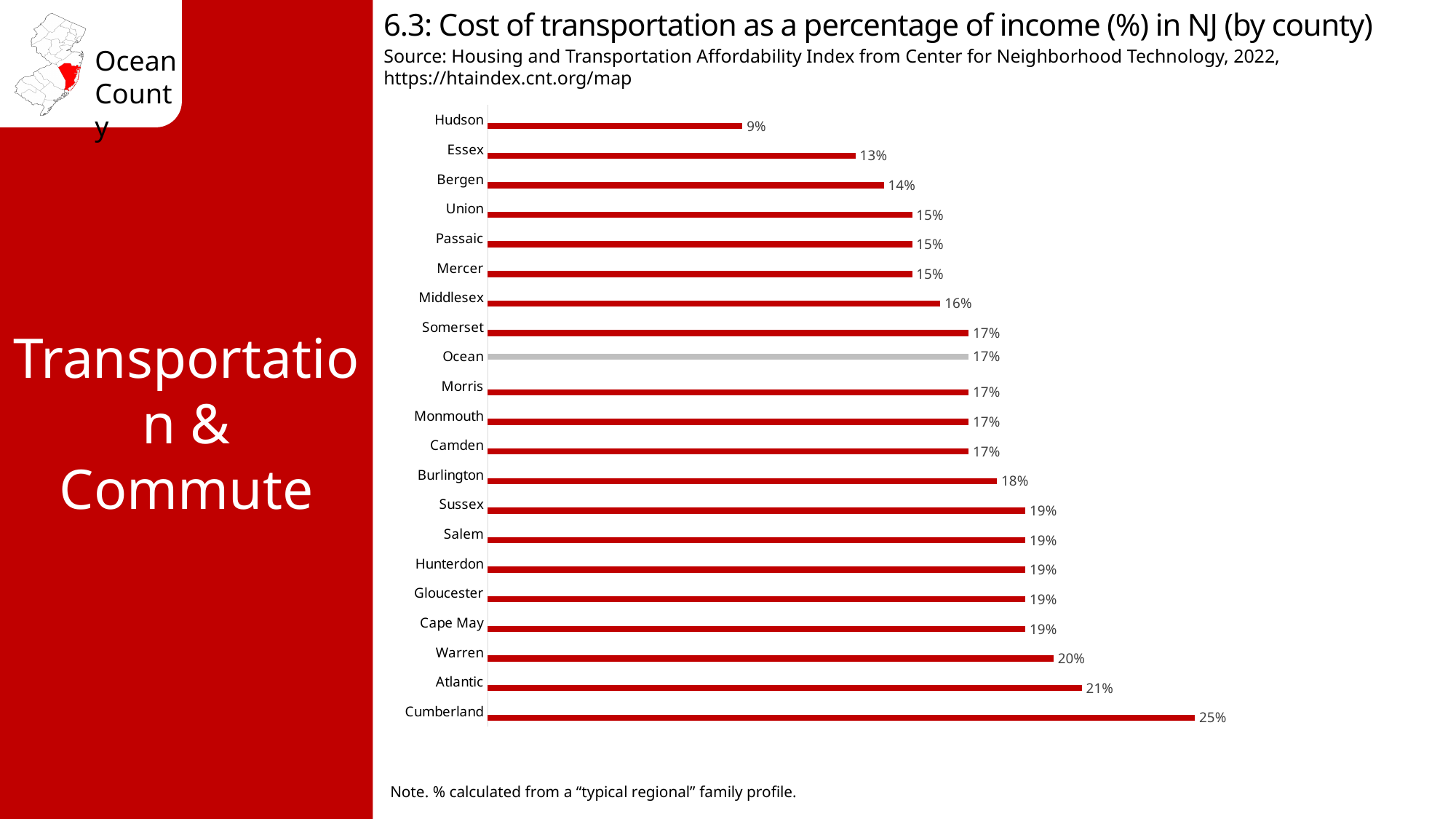
What is the difference between the values for Cumberland and Hudson? 16% What is the value shown for Middlesex? 16% What is the value shown for Hudson? 9% Which county's bar is shown in grey rather than red? Ocean Which county has the highest cost of transportation as a percentage of income? Cumberland What type of chart is used on this slide? Bar chart Which county has the lowest cost of transportation as a percentage of income? Hudson What is the value shown for Cumberland? 25% What is the cost of transportation as a percentage of income for Ocean County? 17% How many counties are shown in the chart? 21 What is the difference between the values for Atlantic and Ocean? 4% Which has a higher value, Warren or Burlington? Warren